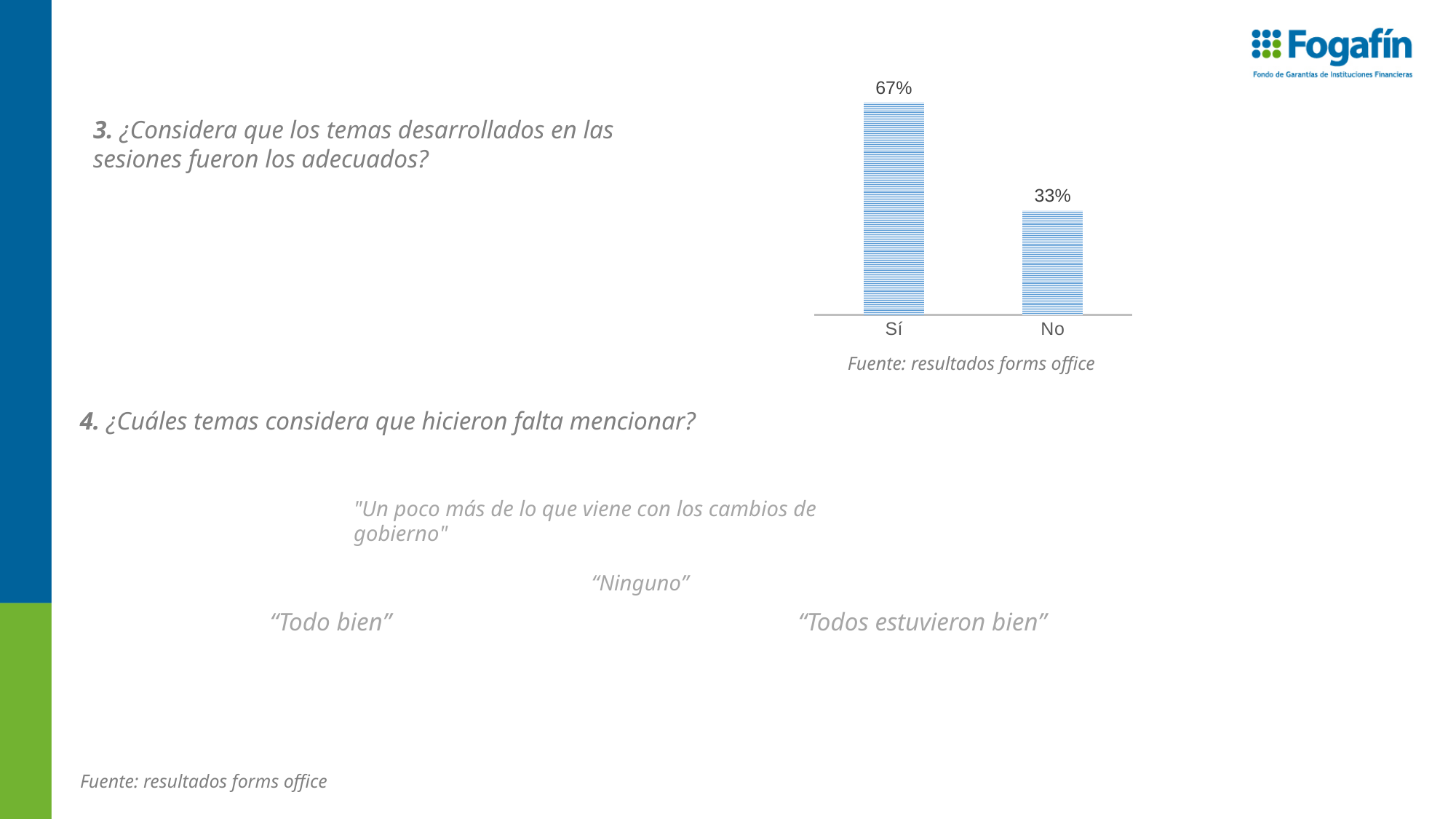
Which category has the lowest value in the bar chart? No What is the value for "No" in the bar chart? 33% What is the total of the two values shown in the bar chart? 100% Which category has the highest value in the bar chart? Sí How many categories are shown in the bar chart? 2 Which is larger in the bar chart, the value for "Sí" or the value for "No"? Sí Which survey question does the bar chart correspond to? 3. ¿Considera que los temas desarrollados en las sesiones fueron los adecuados? What kind of chart is shown on the slide? Bar chart What is the difference between the values for "Sí" and "No" in the bar chart? 34% What source is cited below the bar chart? Fuente: resultados forms office What is the value for "Sí" in the bar chart? 67%